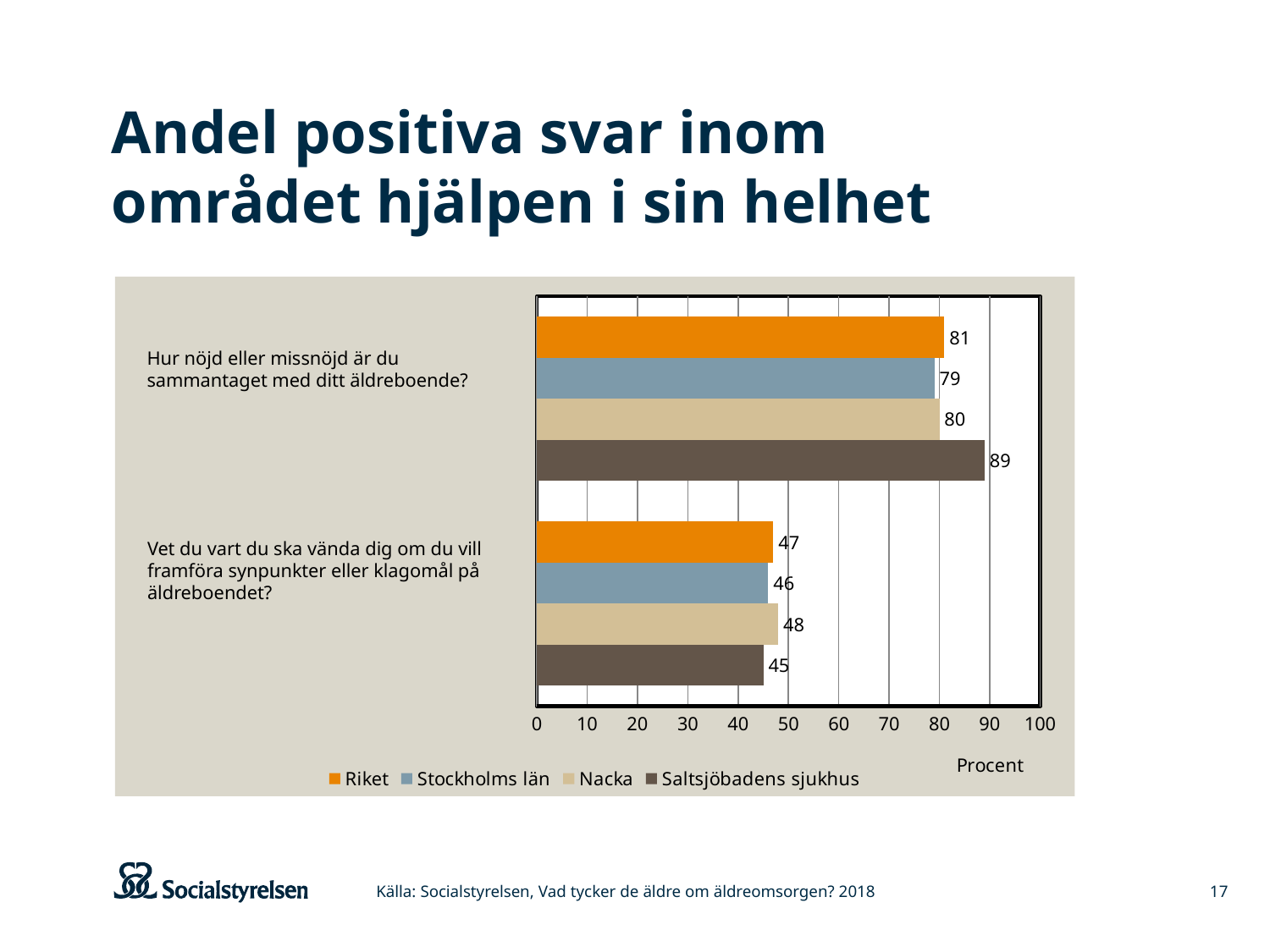
What is the value for Stockholms län on the question 'Hur nöjd eller missnöjd är du sammantaget med ditt äldreboende?' 79 How many series does the legend list? 4 Which series has the highest value on the question 'Hur nöjd eller missnöjd är du sammantaget med ditt äldreboende?' Saltsjöbadens sjukhus Is the value for Riket on the question 'Hur nöjd eller missnöjd är du sammantaget med ditt äldreboende?' greater or less than 70? greater Which series has the lowest value on the question 'Vet du vart du ska vända dig om du vill framföra synpunkter eller klagomål på äldreboendet?' Saltsjöbadens sjukhus What is the value for Saltsjöbadens sjukhus on the question 'Hur nöjd eller missnöjd är du sammantaget med ditt äldreboende?' 89 What kind of chart is shown on the slide? bar chart What is the value for Nacka on the question 'Vet du vart du ska vända dig om du vill framföra synpunkter eller klagomål på äldreboendet?' 48 Which is larger on the question 'Vet du vart du ska vända dig om du vill framföra synpunkter eller klagomål på äldreboendet?': Nacka or Saltsjöbadens sjukhus? Nacka What is the difference between the Saltsjöbadens sjukhus value and the Riket value on the question 'Hur nöjd eller missnöjd är du sammantaget med ditt äldreboende?' 8 What is the label on the horizontal axis of the chart? Procent What is the value for Riket on the question 'Vet du vart du ska vända dig om du vill framföra synpunkter eller klagomål på äldreboendet?' 47